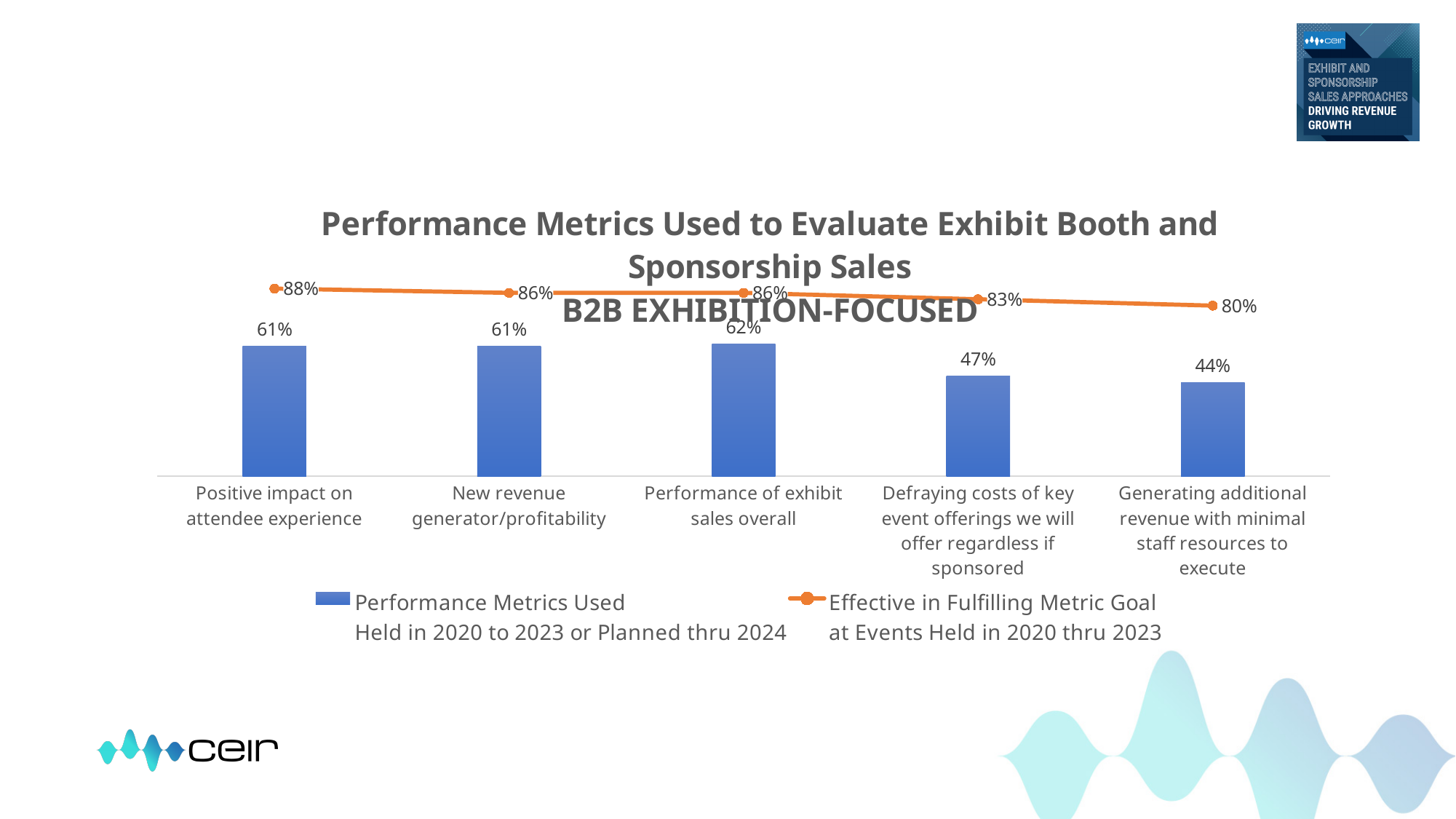
Do the 'Effective in Fulfilling Metric Goal' values rise or fall from left to right across the categories? Fall How many series does the legend list? 2 What kind of chart is shown on the slide? Combined bar and line chart Which is larger: the 'Performance Metrics Used' value for 'Defraying costs of key event offerings we will offer regardless if sponsored' or for 'Generating additional revenue with minimal staff resources to execute'? Defraying costs of key event offerings we will offer regardless if sponsored How many categories are shown on the x axis of the chart? 5 What is the difference between the 'Effective in Fulfilling Metric Goal' value and the 'Performance Metrics Used' value for 'Performance of exhibit sales overall'? 24% What is the 'Effective in Fulfilling Metric Goal' value for 'Generating additional revenue with minimal staff resources to execute'? 80% What colour is the line for 'Effective in Fulfilling Metric Goal'? Orange Which category has the highest 'Effective in Fulfilling Metric Goal' value? Positive impact on attendee experience What percentage of respondents use 'Positive impact on attendee experience' as a performance metric? 61% Which category has the lowest 'Performance Metrics Used' value? Generating additional revenue with minimal staff resources to execute What is the 'Performance Metrics Used' value for 'Defraying costs of key event offerings we will offer regardless if sponsored'? 47%